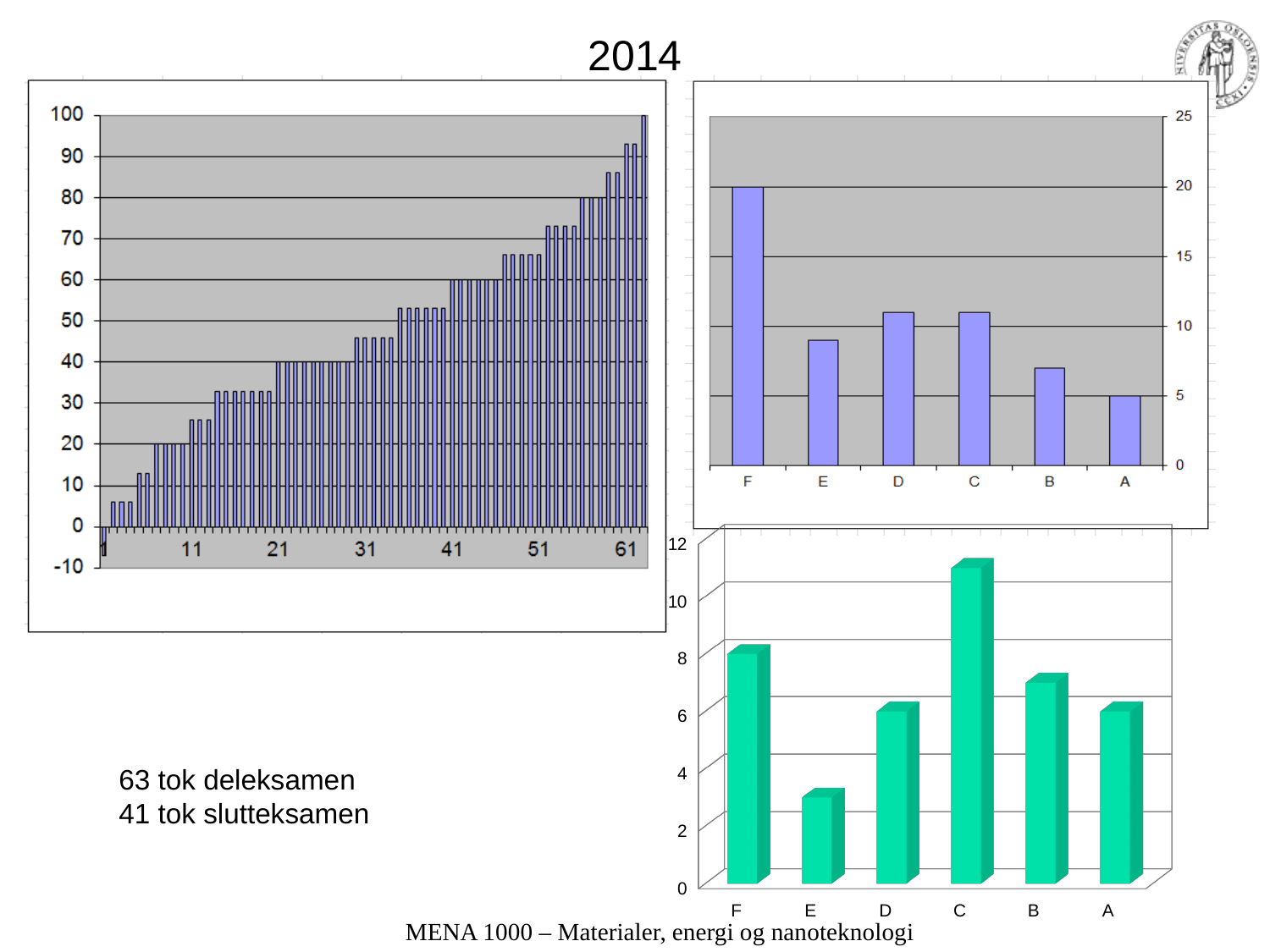
In the top-left chart, do the values rise or fall along the x axis? rise In the bottom-right green chart, what is the value for D? 6 In the top-right chart, is the value for E greater or less than 10? less In the top-right chart, how many categories are shown on the x axis? 6 In the top-right chart, what is the value for F? 20 In the top-right chart, which category has the highest value? F In the bottom-right green chart, which category has the lowest value? E In the top-right chart, what is the value for A? 5 In the top-right chart, which category has the lowest value? A What type of chart is the top-right chart with categories F to A? bar chart In the bottom-right green chart, which category has the highest value? C In the bottom-right green chart, what is the value for F? 8